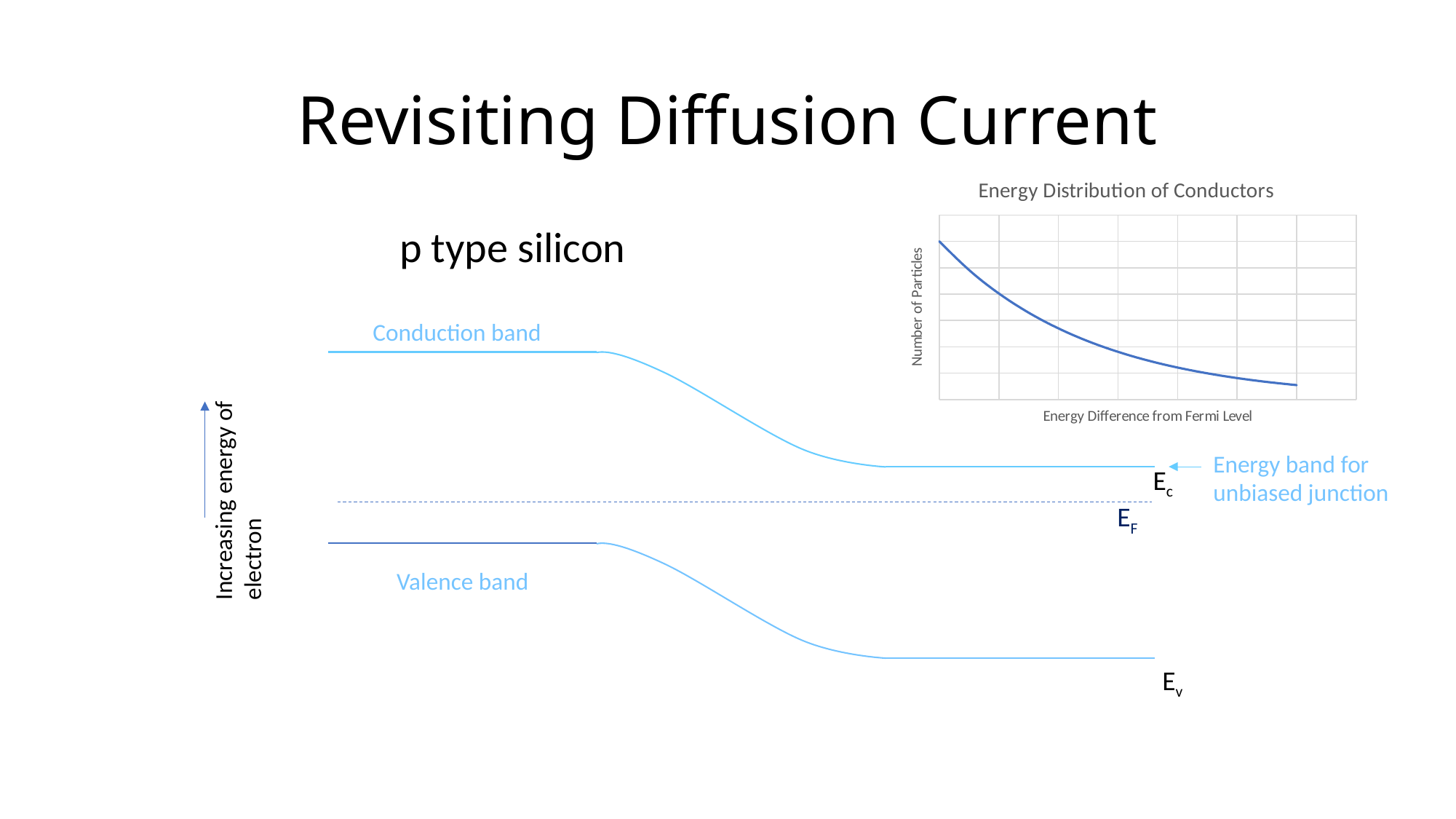
In the "Energy Distribution of Conductors" chart, do the values rise or fall as the energy difference from the Fermi level increases? fall What is the x-axis label of the "Energy Distribution of Conductors" chart? Energy Difference from Fermi Level What kind of chart is the "Energy Distribution of Conductors" chart? line chart What is the title of the chart in the upper right of the slide? Energy Distribution of Conductors How many lines are plotted in the "Energy Distribution of Conductors" chart? 1